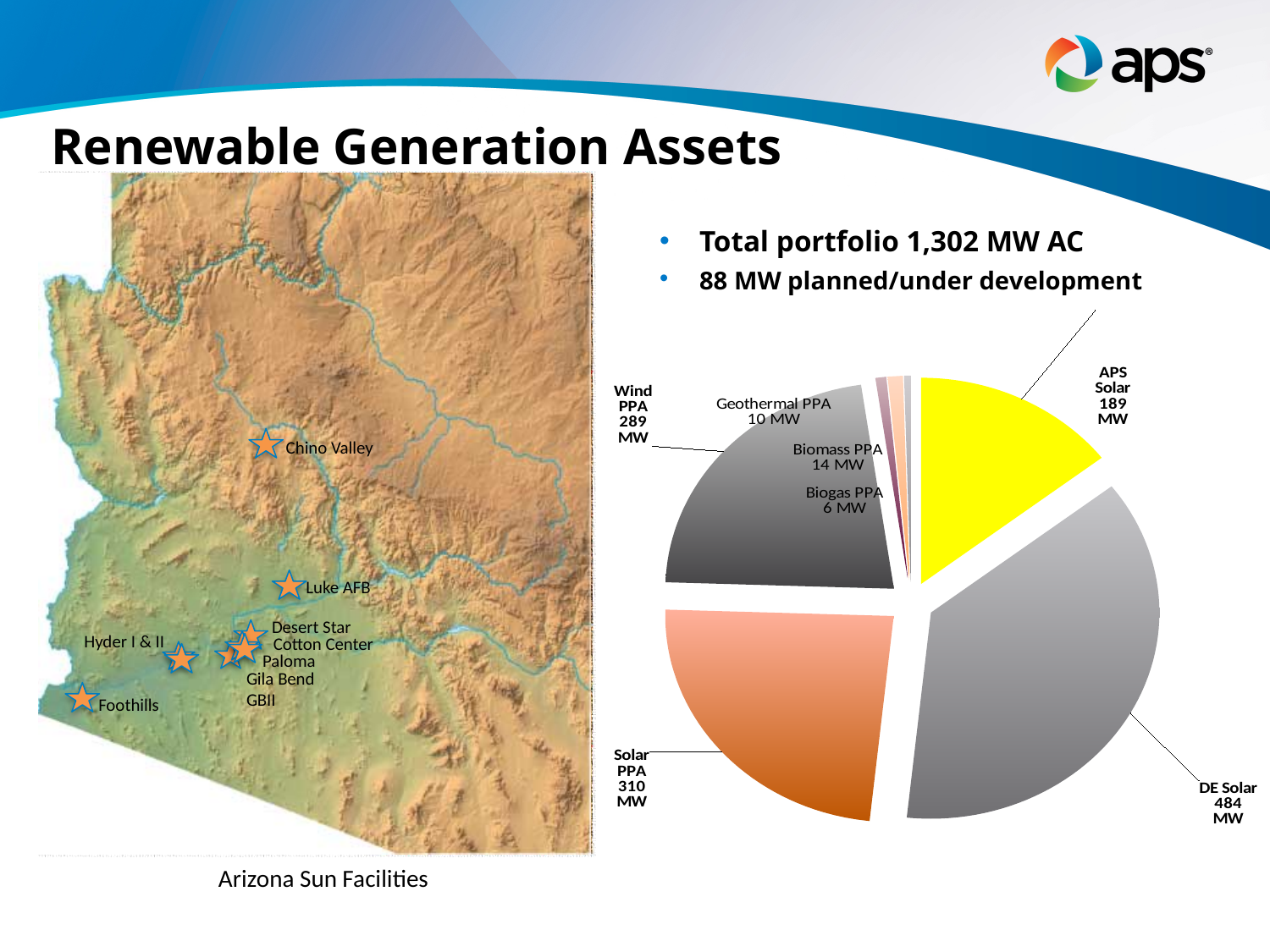
In the pie chart, what is the difference between Biomass PPA and Biogas PPA? 8 MW Which slice of the pie chart has the smallest value? Biogas PPA In the pie chart, what is the value for Geothermal PPA? 10 MW In the pie chart, which is larger: Solar PPA or Wind PPA? Solar PPA What kind of chart is shown on the right side of the slide? Pie chart In the pie chart, what is the difference between DE Solar and Solar PPA? 174 MW In the pie chart, what is the value for DE Solar? 484 MW In the pie chart, what is the value for Wind PPA? 289 MW How many slices does the pie chart have? 7 In the pie chart, which is larger: APS Solar or Wind PPA? Wind PPA Which slice of the pie chart has the largest value? DE Solar What colour is the APS Solar slice in the pie chart? Yellow